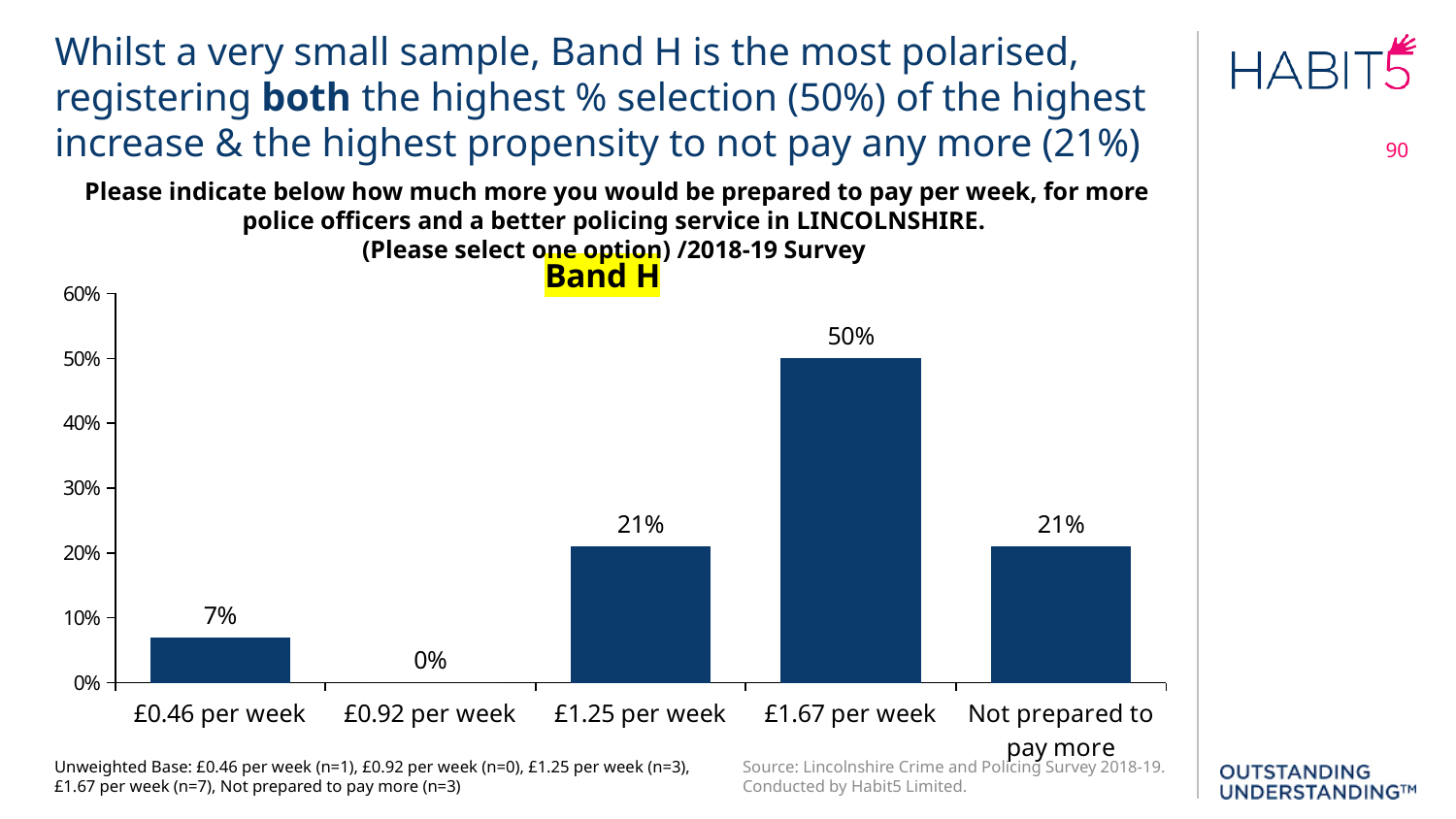
What is the highlighted subtitle of the chart? Band H Which category has the lowest value in the chart? £0.92 per week What is the highest value shown on the y axis of the chart? 60% What percentage of Band H respondents selected £1.67 per week? 50% What is the value shown for £0.46 per week? 7% What percentage of respondents were not prepared to pay more? 21% What type of chart is shown on the slide? Bar chart What is the difference between the values for £1.67 per week and £1.25 per week? 29 percentage points Which category has the highest value in the chart? £1.67 per week Which is larger, the value for £0.46 per week or the value for £1.25 per week? £1.25 per week How many categories are shown on the x axis of the chart? 5 What is the value shown for £0.92 per week? 0%